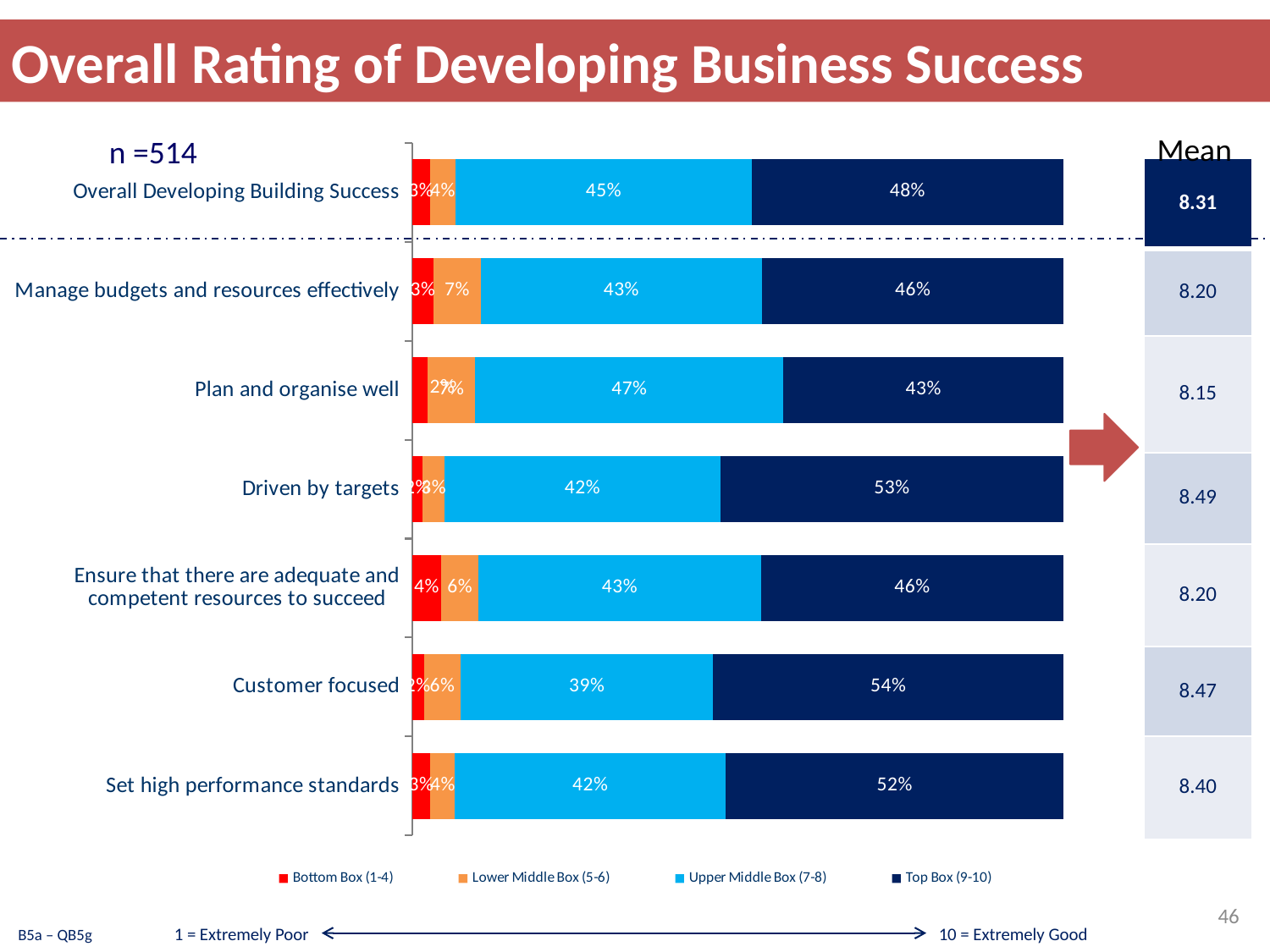
What is the Upper Middle Box (7-8) value for Plan and organise well? 47% Which legend entry is shown in dark blue? Top Box (9-10) Which category has the lowest Top Box (9-10) value? Plan and organise well How many series does the legend list? 4 What is the Top Box (9-10) value for Customer focused? 54% How many categories are shown in the chart? 7 What is the difference between the Top Box (9-10) values for Driven by targets and Plan and organise well? 10 percentage points What is the Mean value shown for Driven by targets? 8.49 Which category has the highest Top Box (9-10) value? Customer focused What is the Lower Middle Box (5-6) value for Manage budgets and resources effectively? 7% What kind of chart is shown on the slide? Stacked bar chart Which has the larger Upper Middle Box (7-8) value: Customer focused or Set high performance standards? Set high performance standards